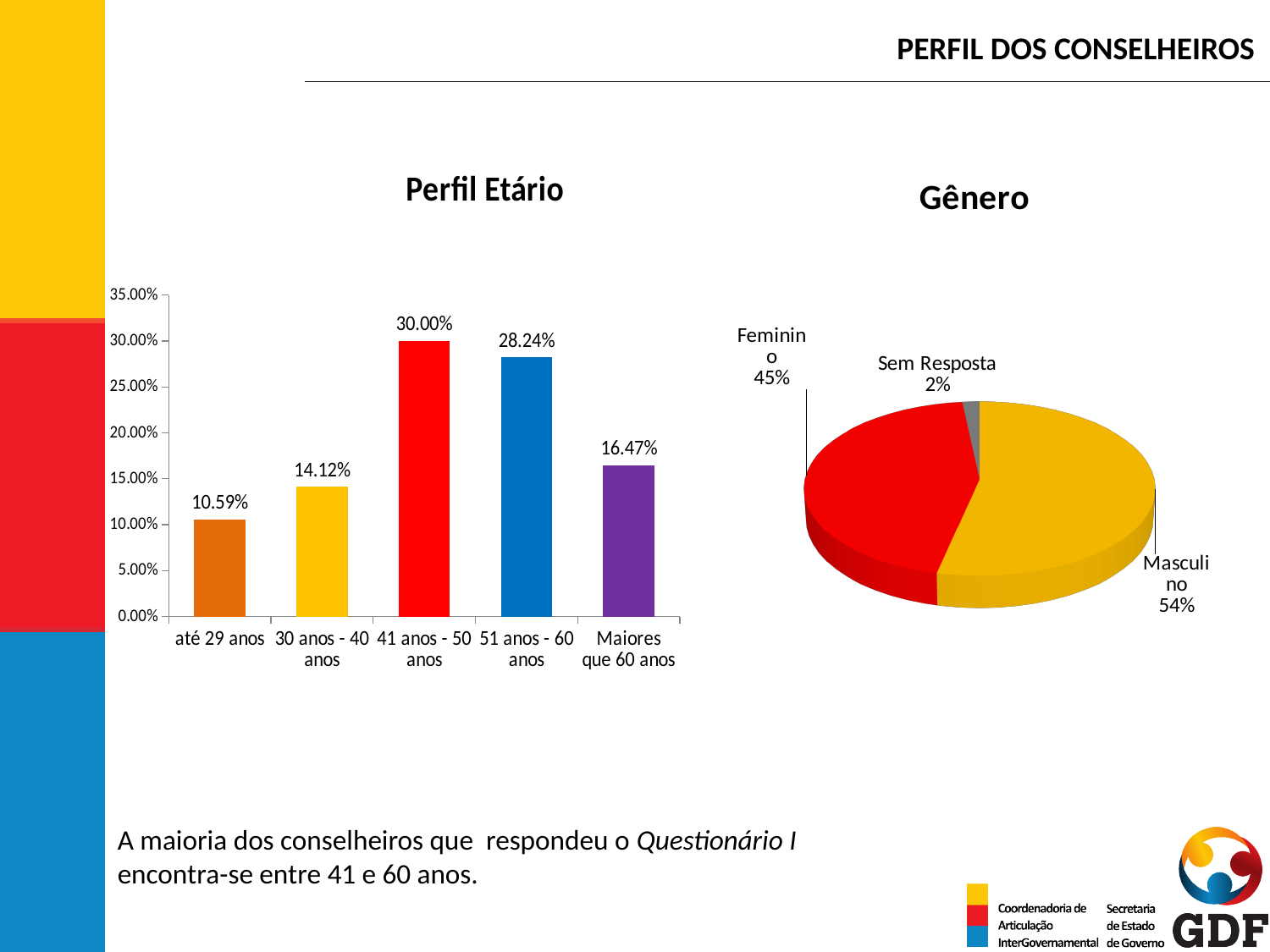
In the 'Perfil Etário' chart, which is larger: '30 anos - 40 anos' or 'Maiores que 60 anos'? Maiores que 60 anos In the 'Perfil Etário' chart, what is the value for 'até 29 anos'? 10.59% In the 'Perfil Etário' chart, how many age categories are shown? 5 In the 'Gênero' chart, what share is 'Masculino'? 54% In the 'Perfil Etário' chart, which age category has the lowest value? até 29 anos In the 'Gênero' chart, which slice is the largest? Masculino In the 'Perfil Etário' chart, what is the value for '41 anos - 50 anos'? 30.00% What kind of chart is 'Perfil Etário'? Bar chart What kind of chart is 'Gênero'? Pie chart In the 'Perfil Etário' chart, what is the difference between '51 anos - 60 anos' and 'Maiores que 60 anos'? 11.77% In the 'Gênero' chart, what share is 'Sem Resposta'? 2% In the 'Perfil Etário' chart, which age category has the highest value? 41 anos - 50 anos